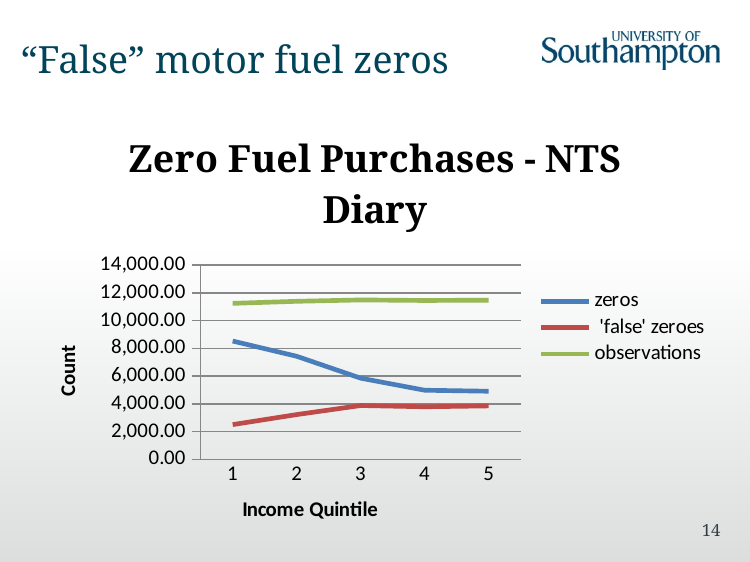
Which series has the highest value at income quintile 3? observations How many series does the legend list? 3 How many income quintiles are plotted on the x axis? 5 Is the value for 'false' zeroes at income quintile 1 greater or less than 4,000.00? less Is the value for observations at income quintile 3 greater or less than 10,000.00? greater What is the title of the chart? Zero Fuel Purchases - NTS Diary At income quintile 1, which is larger: zeros or 'false' zeroes? zeros Is the value for zeros at income quintile 1 greater or less than 8,000.00? greater What kind of chart is shown on the slide? line chart Do the values for zeros rise or fall as income quintile increases from 1 to 5? fall At which income quintile is the value for zeros highest? 1